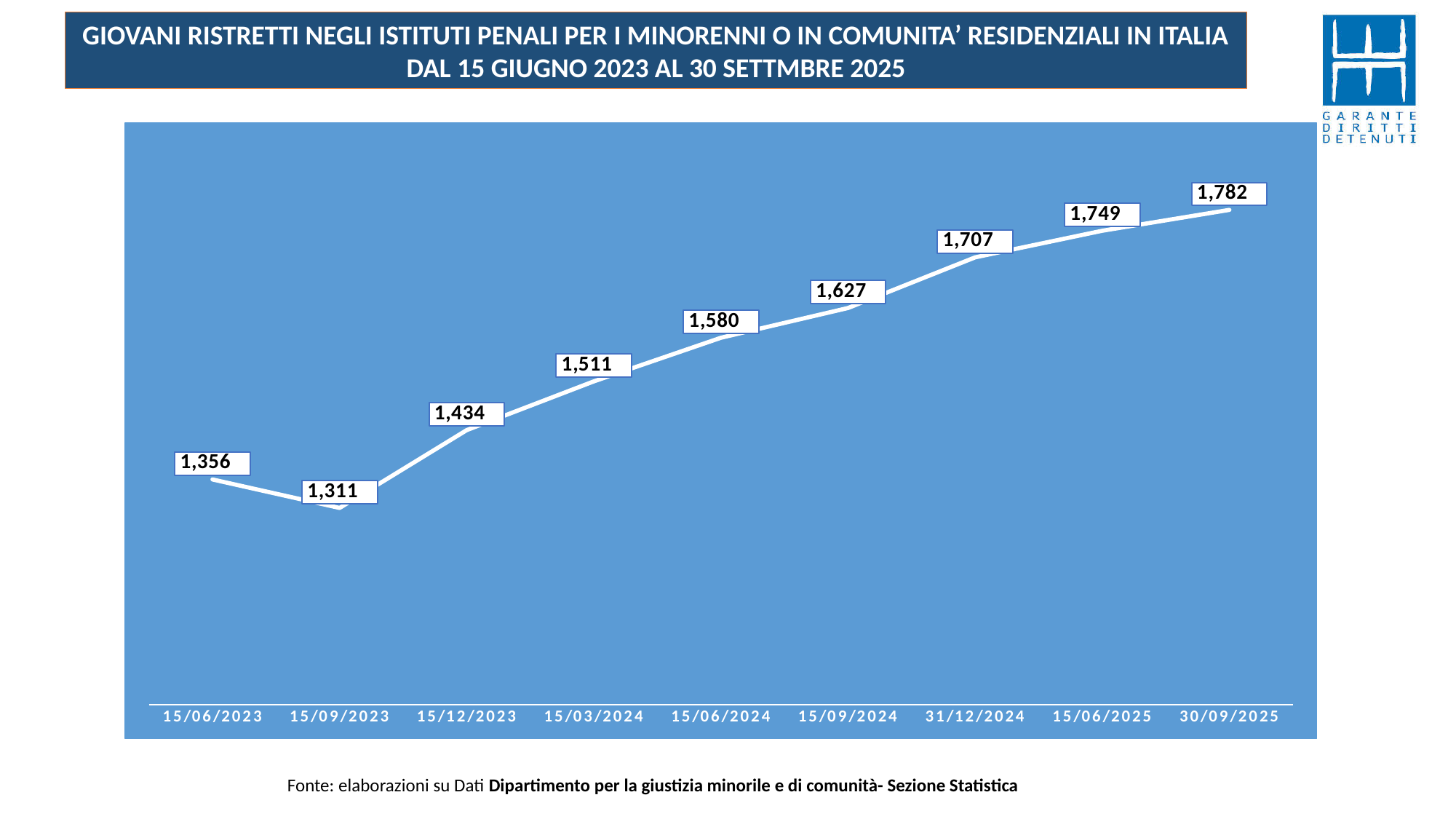
What is the value for 15/06/2023? 1,356 What is the difference between the values for 15/12/2023 and 15/09/2023? 123 What kind of chart is shown on the slide? line chart What is the value for 15/06/2024? 1,580 How many data points are plotted on the chart? 9 What is the value for 30/09/2025? 1,782 Do the values rise or fall from 15/09/2023 to 30/09/2025? rise What is the value for 15/09/2023? 1,311 Which date has the highest value? 30/09/2025 Which date has the lowest value? 15/09/2023 Which is larger, the value for 15/03/2024 or the value for 15/09/2024? 15/09/2024 What is the difference between the values for 30/09/2025 and 15/06/2023? 426